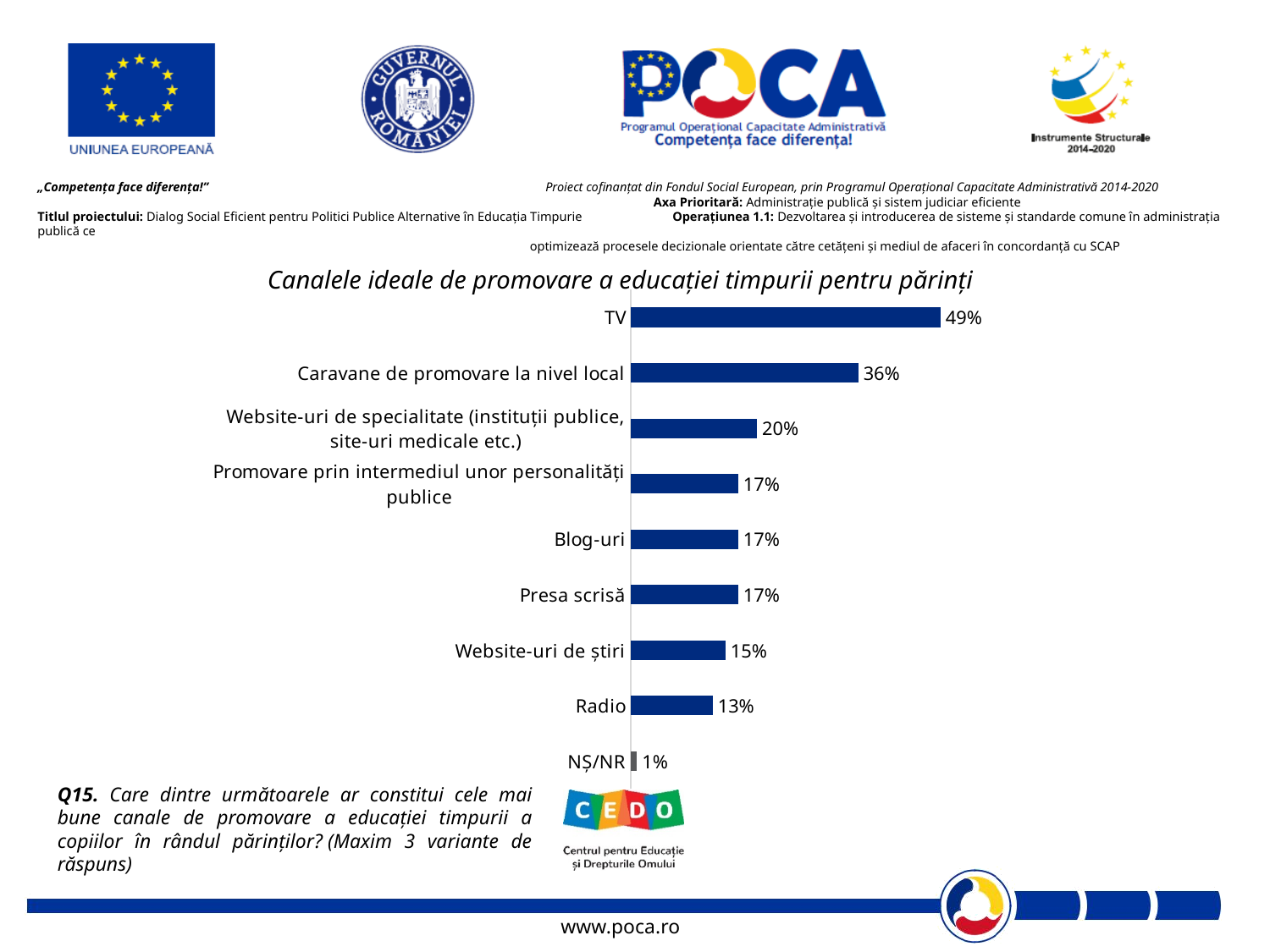
How many categories are shown in the chart? 9 What is the value for TV? 49% What is the title of the chart? Canalele ideale de promovare a educației timpurii pentru părinți What is the value for Caravane de promovare la nivel local? 36% Which category has the lowest value? NȘ/NR Which is larger, the value for Radio or the value for Website-uri de știri? Website-uri de știri What kind of chart is shown on the slide? bar chart What is the value for Website-uri de știri? 15% What is the difference between the values for TV and Caravane de promovare la nivel local? 13% Which category has the highest value? TV What is the value for Radio? 13% What is the value for Blog-uri? 17%